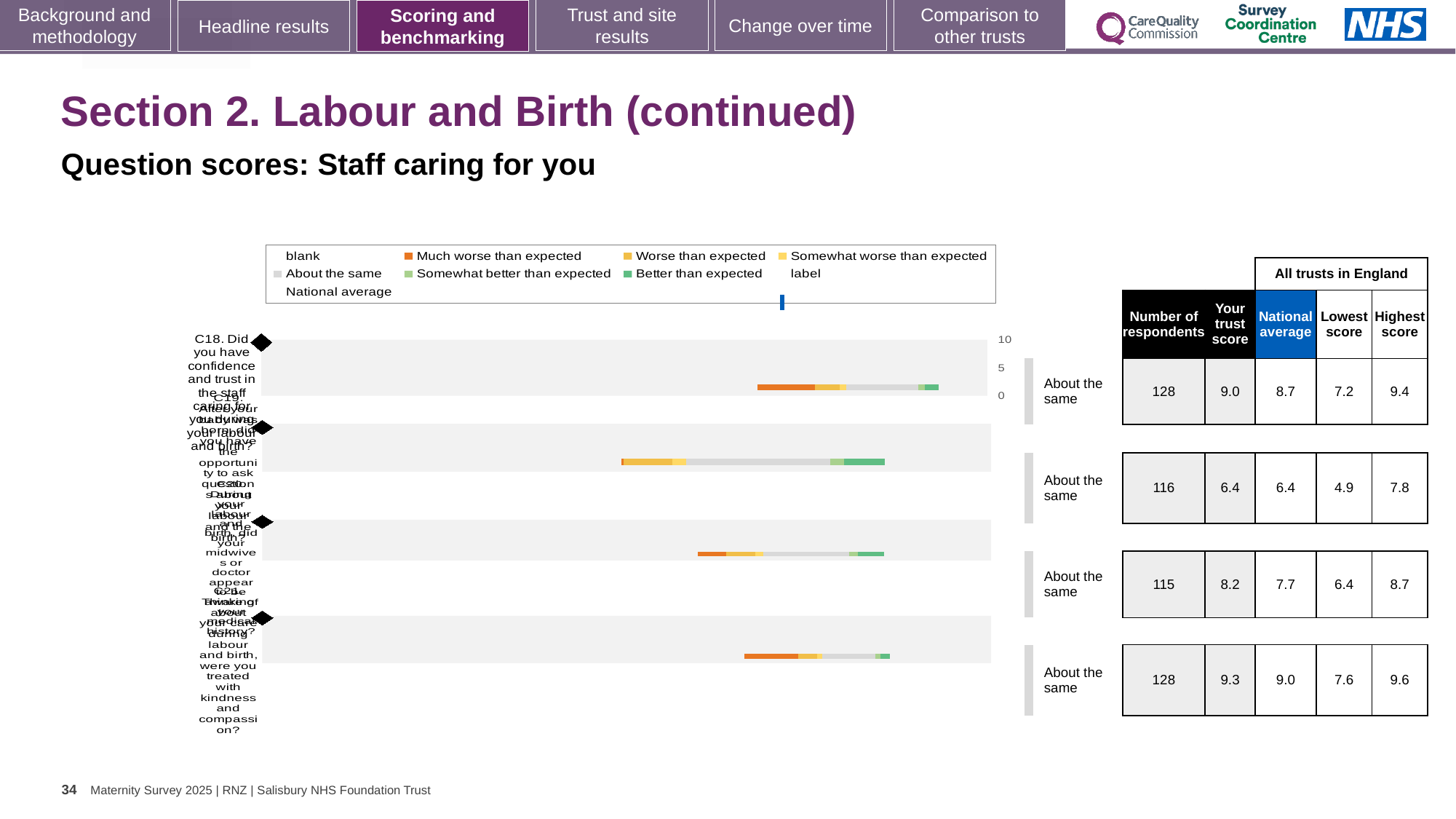
What is the highest score in England for the fourth question in the table? 9.6 What is the trust score for the first question (C18, confidence and trust in staff)? 9.0 What is the lowest score in England for the third question in the table? 6.4 Which row has the lowest trust score? The second row (6.4) What is the national average for the first question (C18)? 8.7 What is the difference between the trust score and the national average for the third question? 0.5 What kind of chart is shown on the slide? Bar chart How many questions (rows) are plotted in the chart? 4 Which row has the highest trust score? The fourth row (9.3) For the first question, is the trust score or the national average larger? Trust score (9.0) How many respondents answered the second question in the table? 116 What benchmark label is shown for all four questions? About the same